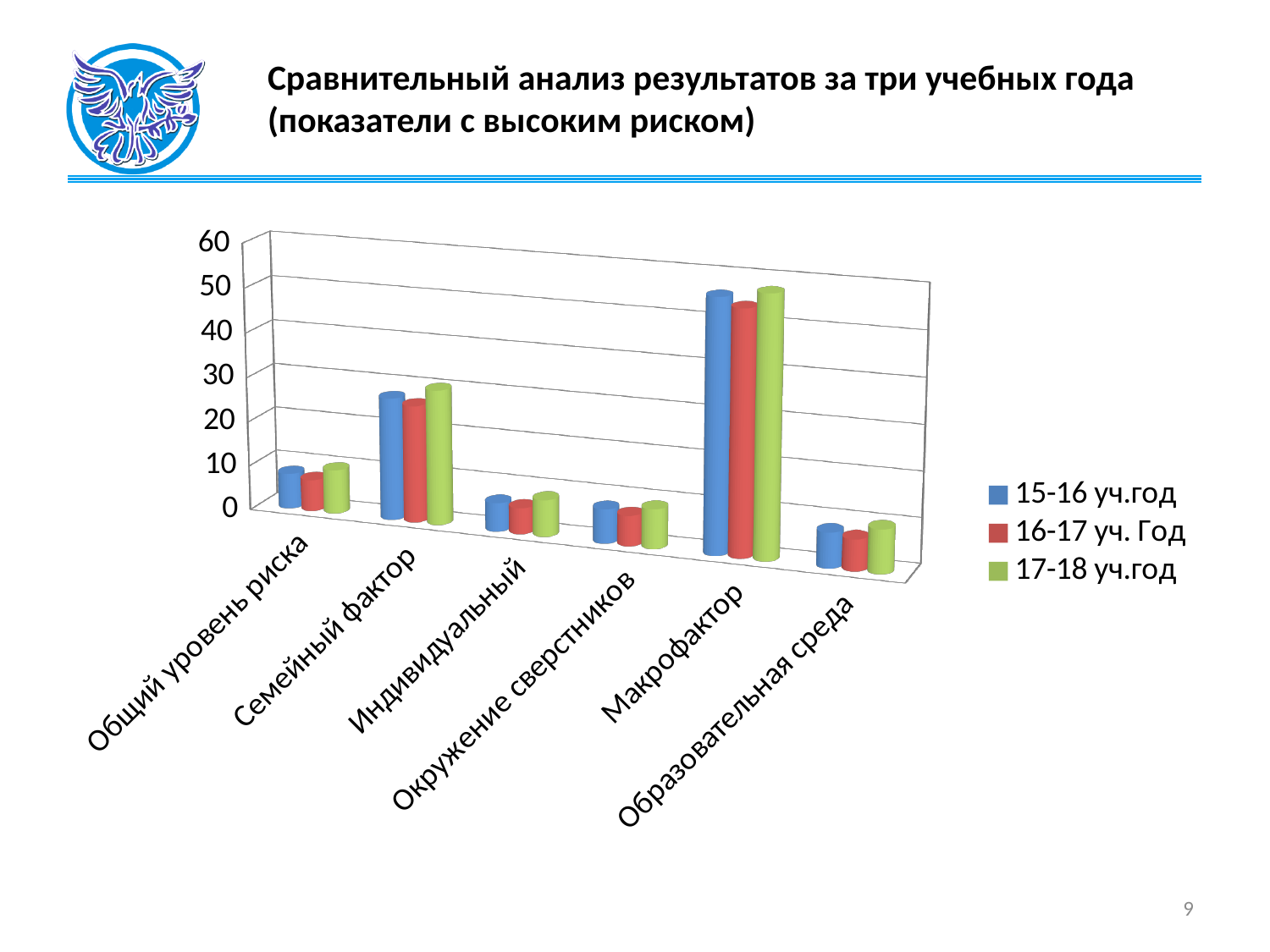
Is the value for Общий уровень риска in the 15-16 уч.год series greater or less than 10? less What is the title of the slide containing the chart? Сравнительный анализ результатов за три учебных года (показатели с высоким риском) Which is larger for the 17-18 уч.год series: Семейный фактор or Общий уровень риска? Семейный фактор Which category has the highest values across all three series? Макрофактор Is the value for Индивидуальный in the 16-17 уч. Год series greater or less than 10? less How many series does the legend list? 3 How many categories are shown on the x axis of the chart? 6 Is the value for Семейный фактор in the 17-18 уч.год series greater or less than 20? greater Which is larger for the 15-16 уч.год series: Макрофактор or Семейный фактор? Макрофактор What kind of chart is shown on the slide? bar chart Which series is shown in green in the legend? 17-18 уч.год